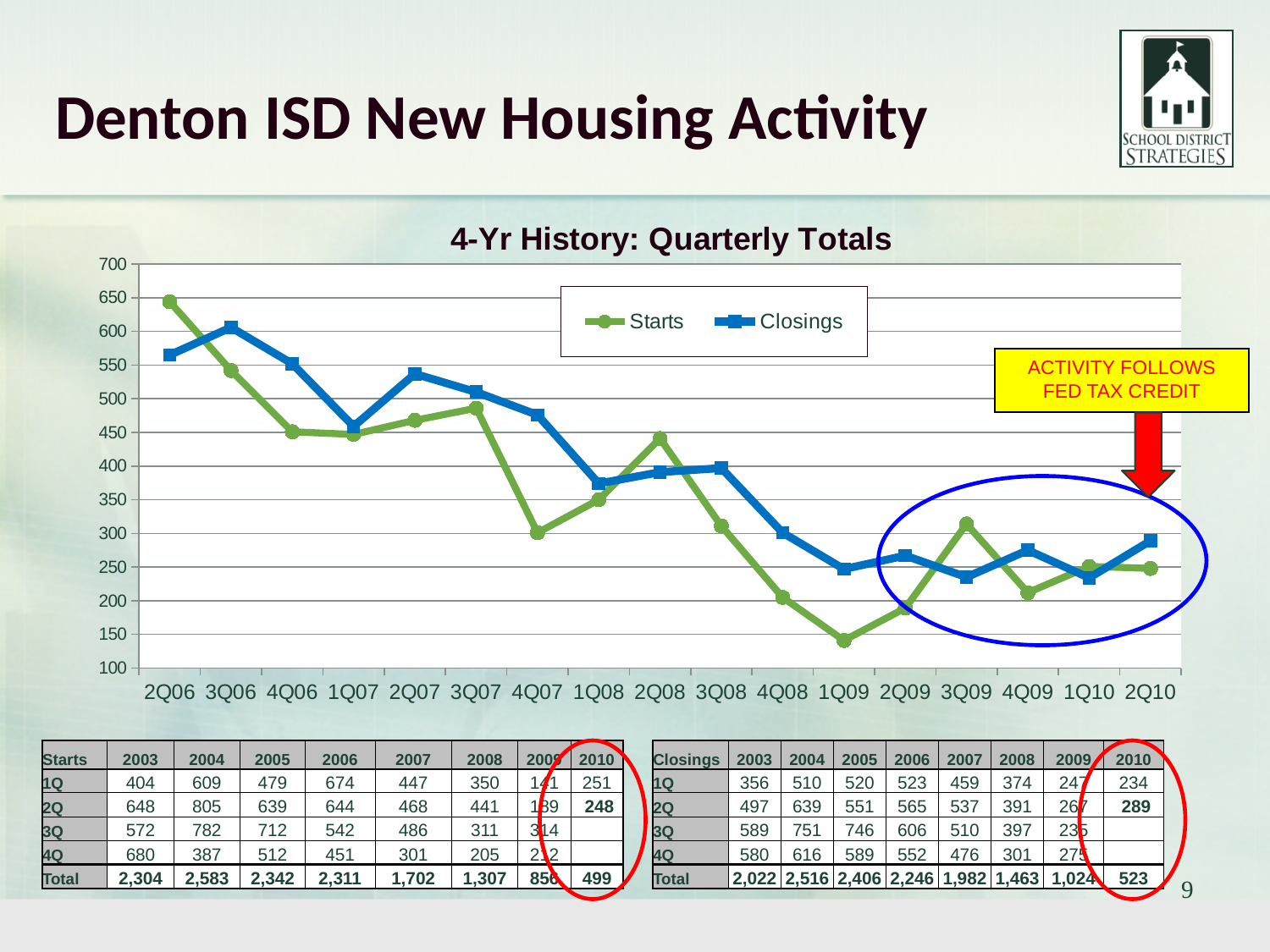
What does the yellow callout box on the chart say? ACTIVITY FOLLOWS FED TAX CREDIT In which quarter is the Starts series at its highest? 2Q06 In which quarter is the Closings series at its highest? 3Q06 Overall, do the Starts values rise or fall from 2Q06 to 2Q10? fall Is the Closings value for 2Q07 greater or less than 500? greater How many series does the legend of the chart list? 2 What type of chart is shown under the title "4-Yr History: Quarterly Totals"? line chart In which quarter is the Starts series at its lowest? 1Q09 Is the Starts value for 2Q06 greater or less than 600? greater At 1Q09, which series has the larger value, Starts or Closings? Closings How many quarters are plotted along the x axis of the chart? 17 Is the Starts value for 1Q09 greater or less than 200? less